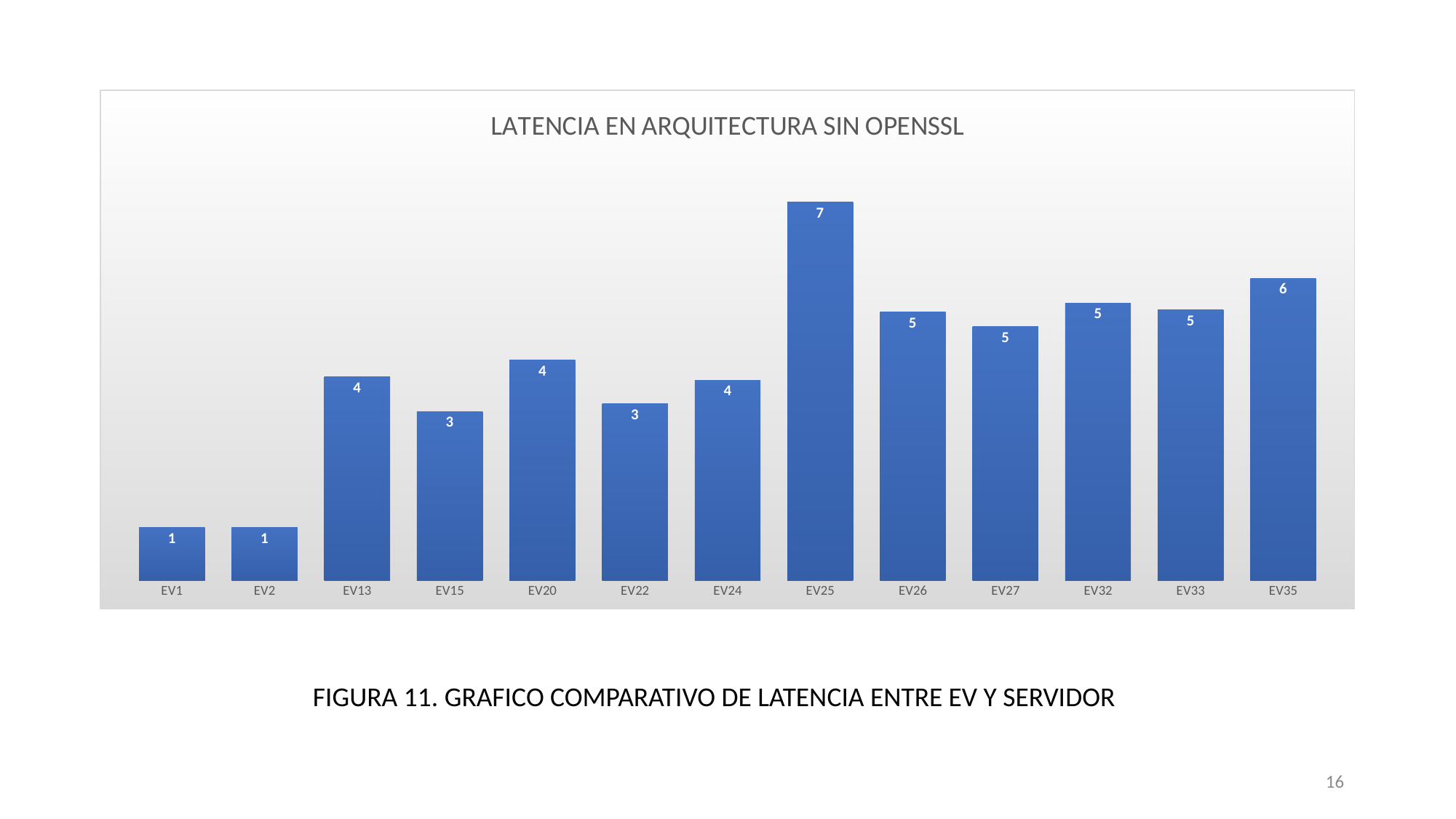
What is the value for EV1? 1 What is the difference between the values for EV25 and EV35? 1 What is the difference between the values for EV26 and EV2? 4 What is the lowest value shown in the chart? 1 What is the title of the chart? LATENCIA EN ARQUITECTURA SIN OPENSSL What is the value for EV25? 7 What is the value for EV15? 3 Which category has the highest value? EV25 What kind of chart is shown on the slide? Bar chart Which is larger, the value for EV13 or the value for EV22? EV13 What is the value for EV35? 6 How many categories are shown on the x axis? 13